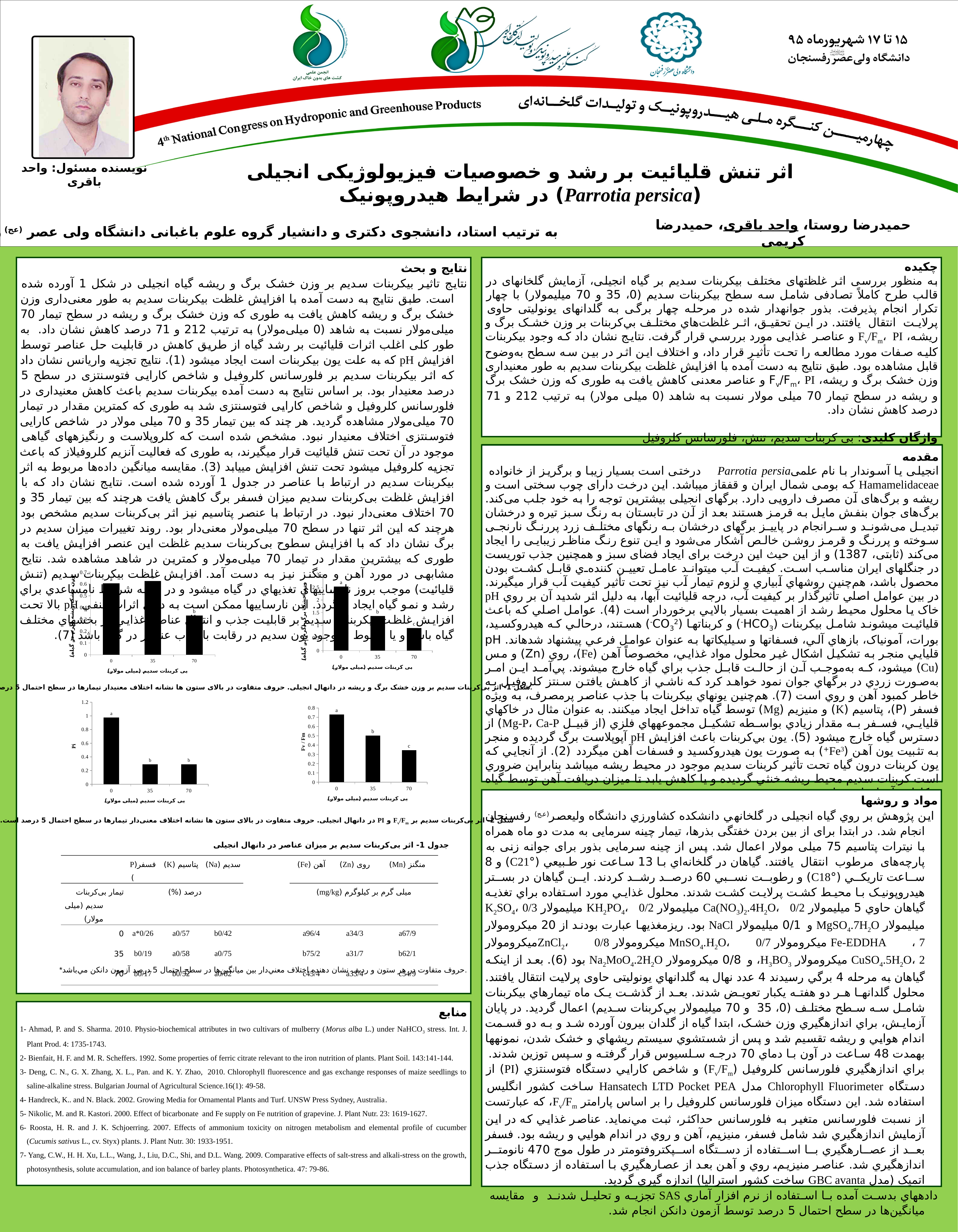
What kind of chart is the PI chart? bar chart In the PI chart (bottom-left of the charts), is the value for the 0 mM treatment greater or less than 0.8? greater In the leaf dry weight chart (top-left of the charts), which is larger, the value for 35 mM or for 70 mM? 35 mM In the root dry weight chart (top-right of the charts), is the value for the 0 mM treatment greater or less than 1.5? greater How many sodium bicarbonate levels are shown on the x axis of the Fv/Fm chart? 3 In the Fv/Fm chart (bottom-right of the charts), which sodium bicarbonate level has the highest Fv/Fm value? 0 In the PI chart, which sodium bicarbonate level has the highest PI value? 0 In the PI chart (bottom-left of the charts), is the value for the 35 mM treatment greater or less than 0.4? less In the Fv/Fm chart (bottom-right of the charts), which sodium bicarbonate level has the lowest Fv/Fm value? 70 In the root dry weight chart (top-right of the charts), which sodium bicarbonate level has the lowest root dry weight? 70